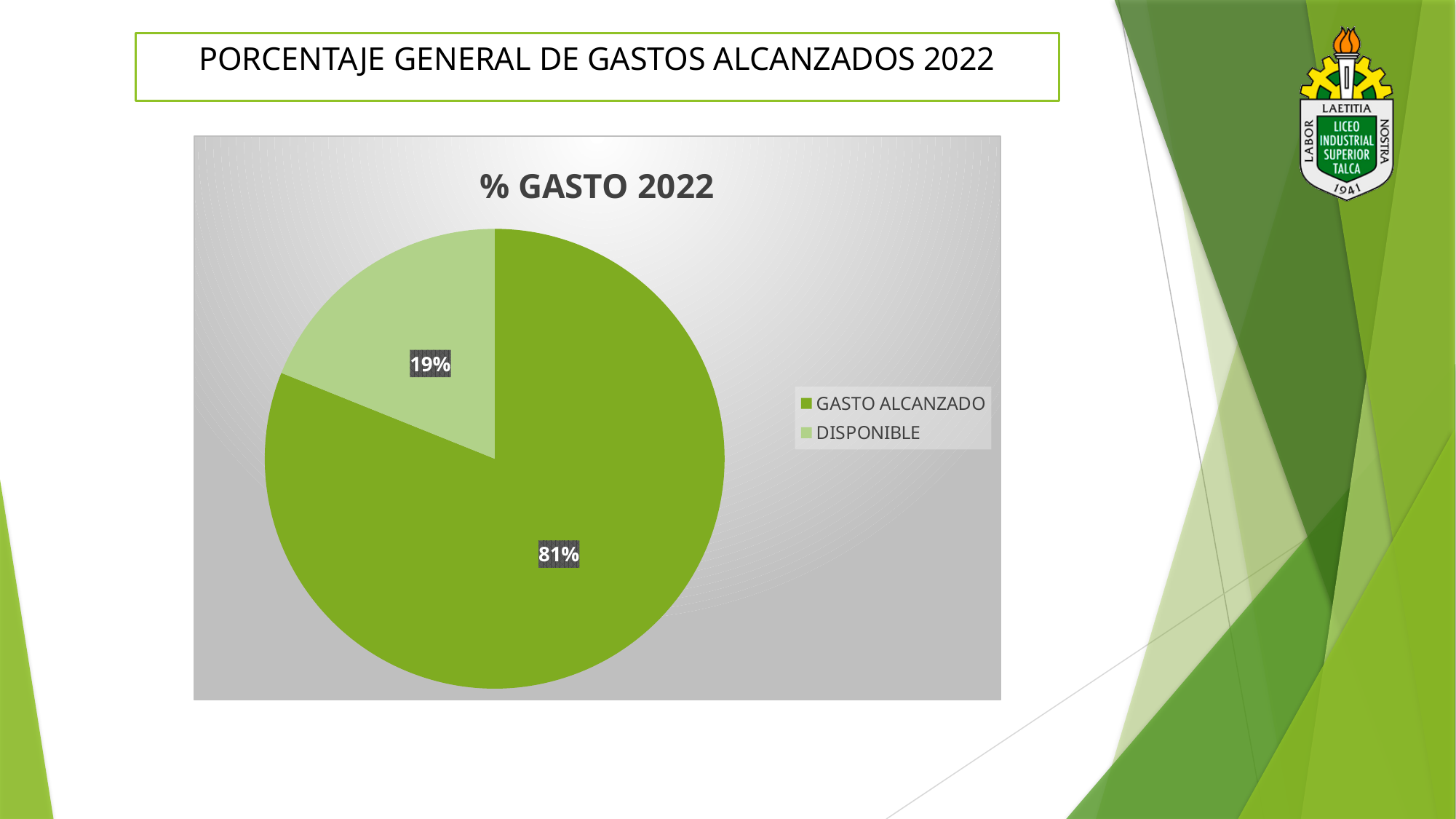
What share of the pie does DISPONIBLE represent? 19% How many entries does the legend list? 2 What percentage is shown for DISPONIBLE? 19% What percentage is shown for GASTO ALCANZADO? 81% Which slice of the pie is the smallest? DISPONIBLE What is the title of the chart? % GASTO 2022 What is the difference in percentage points between GASTO ALCANZADO and DISPONIBLE? 62 Which legend entry is shown in the lighter green colour? DISPONIBLE Which slice of the pie is the largest? GASTO ALCANZADO How many slices does the pie chart have? 2 What kind of chart is shown on the slide? pie chart Which is larger, GASTO ALCANZADO or DISPONIBLE? GASTO ALCANZADO